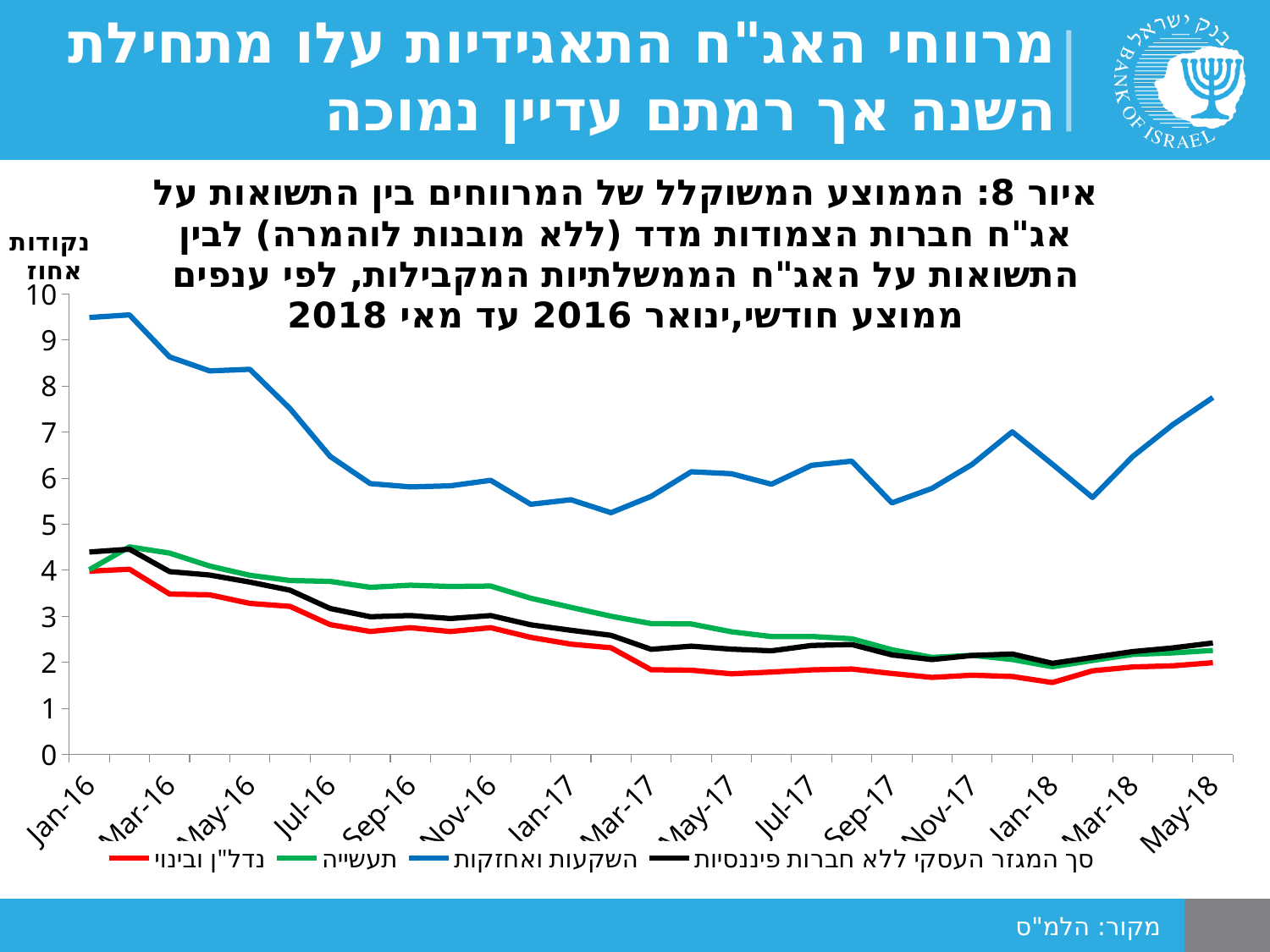
How many series does the legend list? 4 Does the value for השקעות ואחזקות rise or fall from Jan-16 to Sep-16? fall Is the value for תעשייה in Jan-16 greater or less than 5? less Which series has the lowest value in Jan-18? נדל"ן ובינוי What kind of chart is shown on the slide? line chart Is the value for נדל"ן ובינוי in Jan-18 greater or less than 2? less Does the value for נדל"ן ובינוי rise or fall from Jan-18 to May-18? rise Is the value for השקעות ואחזקות in Jan-16 greater or less than 9? greater What is the label on the vertical axis of the chart? נקודות אחוז Which is larger in Jan-16: the value for השקעות ואחזקות or the value for תעשייה? השקעות ואחזקות Which series has the highest values throughout the period shown? השקעות ואחזקות